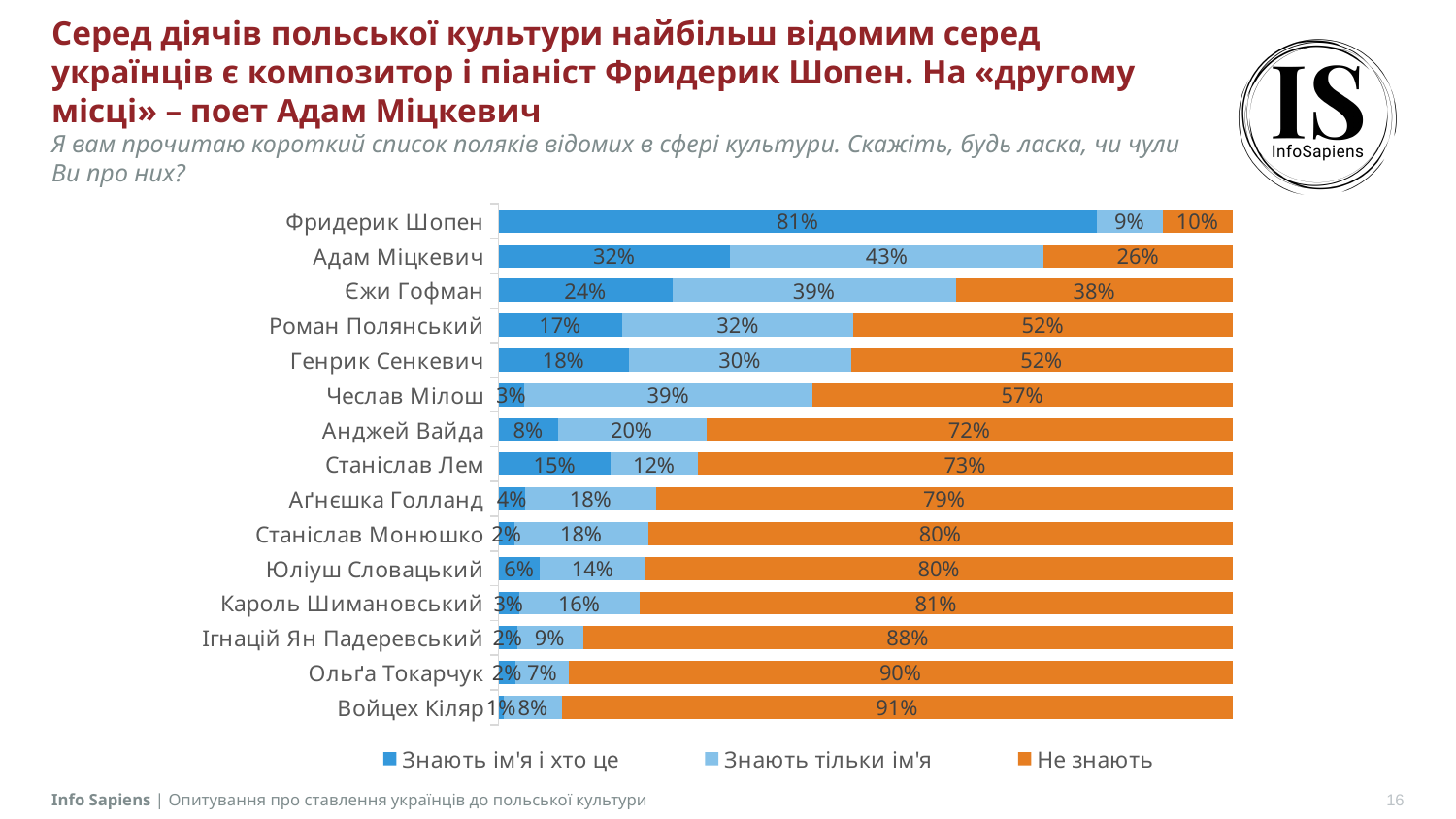
How many people (categories) are shown in the chart? 15 What is the value of "Знають тільки ім'я" for Чеслав Мілош? 39% Which series is shown in orange in the legend? Не знають What is the difference between the "Не знають" values for Ольґа Токарчук and Анджей Вайда? 18% What type of chart is shown on the slide? Stacked bar chart What is the value of "Не знають" for Адам Міцкевич? 26% Which person has the highest value in the "Не знають" series? Войцех Кіляр What percentage of respondents know the name and who Фридерик Шопен is (series "Знають ім'я і хто це")? 81% What is the total of the three segments for Станіслав Лем? 100% Which person has the lowest value in the "Не знають" series? Фридерик Шопен Which is larger: the "Знають ім'я і хто це" value for Єжи Гофман or for Станіслав Лем? Єжи Гофман How many series does the legend list? 3